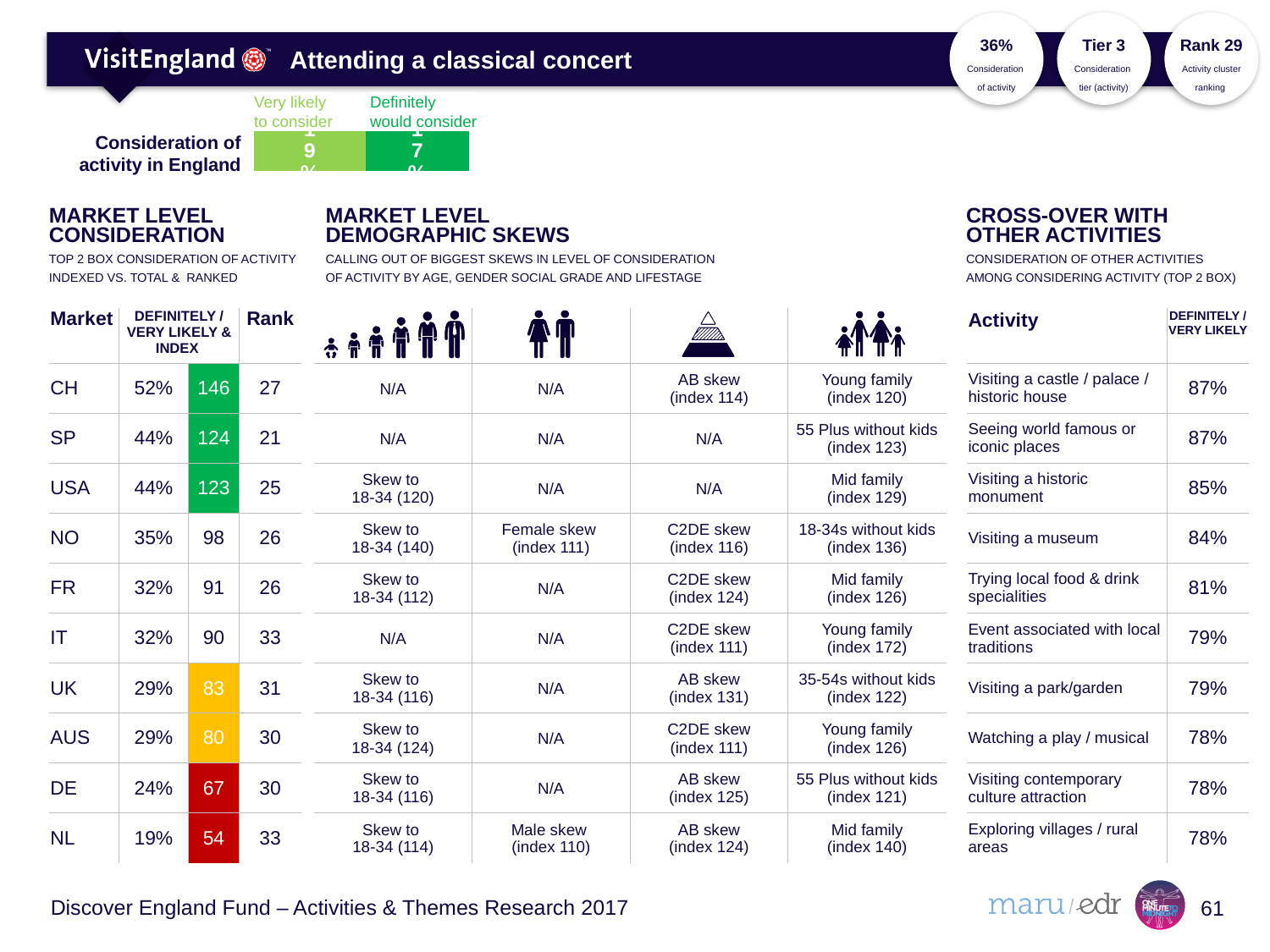
How many bars does the 'Consideration of activity in England' chart show? 2 In the 'Consideration of activity in England' chart, what is the combined total of 'Very likely to consider' and 'Definitely would consider'? 36% In the 'Consideration of activity in England' chart, which category has the lower value? Definitely would consider What colour is the 'Definitely would consider' bar in the 'Consideration of activity in England' chart? dark green In the 'Consideration of activity in England' chart, what is the value for 'Definitely would consider'? 17% In the 'Consideration of activity in England' chart, is the value for 'Very likely to consider' larger or smaller than the value for 'Definitely would consider'? larger What are the two category labels shown above the bars in the 'Consideration of activity in England' chart? Very likely to consider; Definitely would consider In the 'Consideration of activity in England' chart, what is the value for 'Very likely to consider'? 19% In the 'Consideration of activity in England' chart, what is the difference between 'Very likely to consider' and 'Definitely would consider'? 2% What kind of chart is the 'Consideration of activity in England' chart? bar chart In the 'Consideration of activity in England' chart, which category has the higher value? Very likely to consider